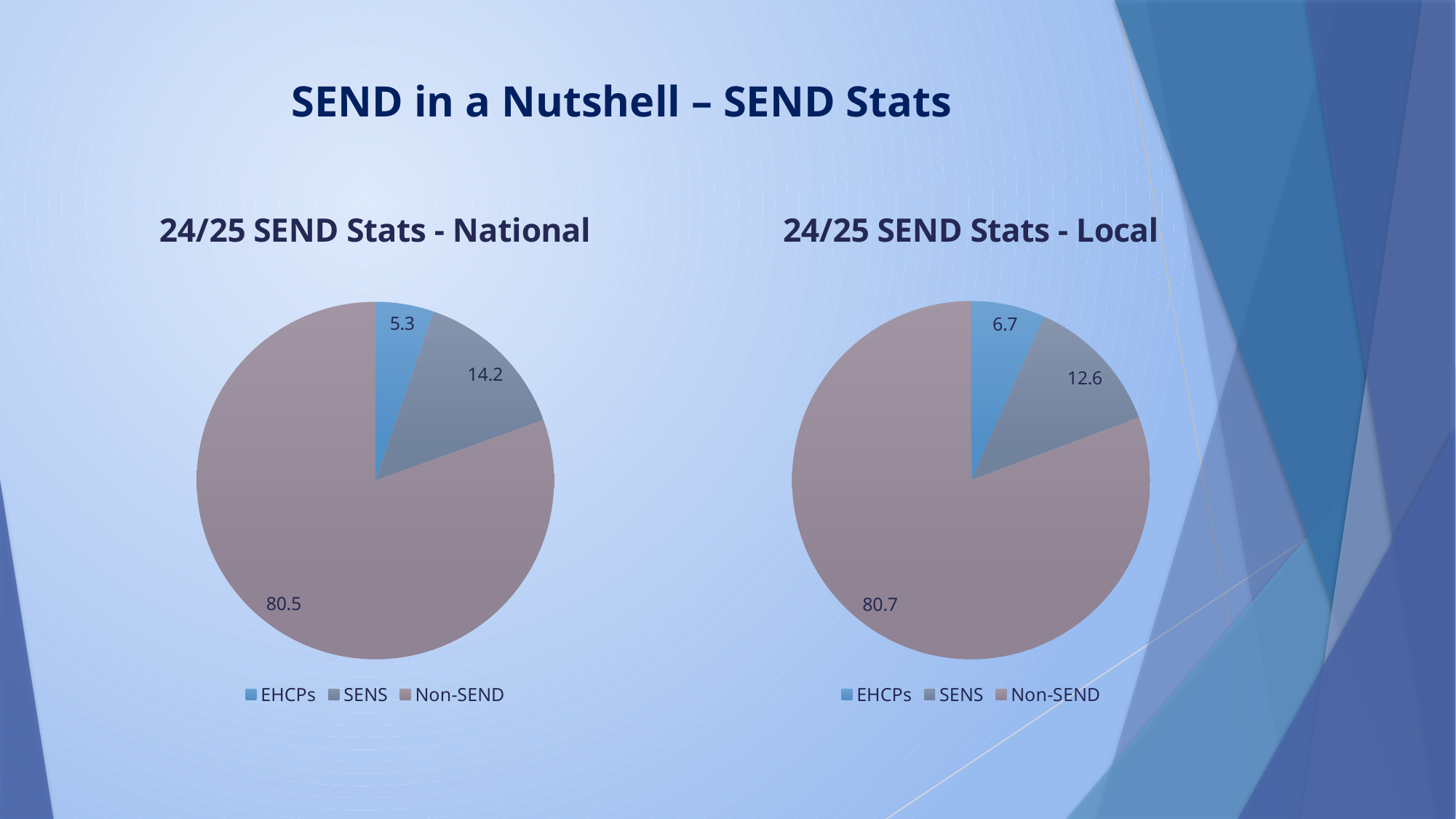
Which chart shows a larger value for EHCPs, National or Local? Local What is the difference between the SENS values in the National chart and the Local chart? 1.6 What type of chart is '24/25 SEND Stats - Local'? Pie chart In the '24/25 SEND Stats - Local' chart, what is the value for SENS? 12.6 In the '24/25 SEND Stats - National' chart, which category has the smallest slice? EHCPs In the '24/25 SEND Stats - National' chart, what is the value for Non-SEND? 80.5 In the '24/25 SEND Stats - National' chart, what is the value for EHCPs? 5.3 In the '24/25 SEND Stats - Local' chart, which category has the largest slice? Non-SEND How many entries does the legend of the '24/25 SEND Stats - Local' chart list? 3 How many slices does the '24/25 SEND Stats - National' pie chart have? 3 In the '24/25 SEND Stats - Local' chart, what is the value for EHCPs? 6.7 What is the title of the chart on the left of the slide? 24/25 SEND Stats - National